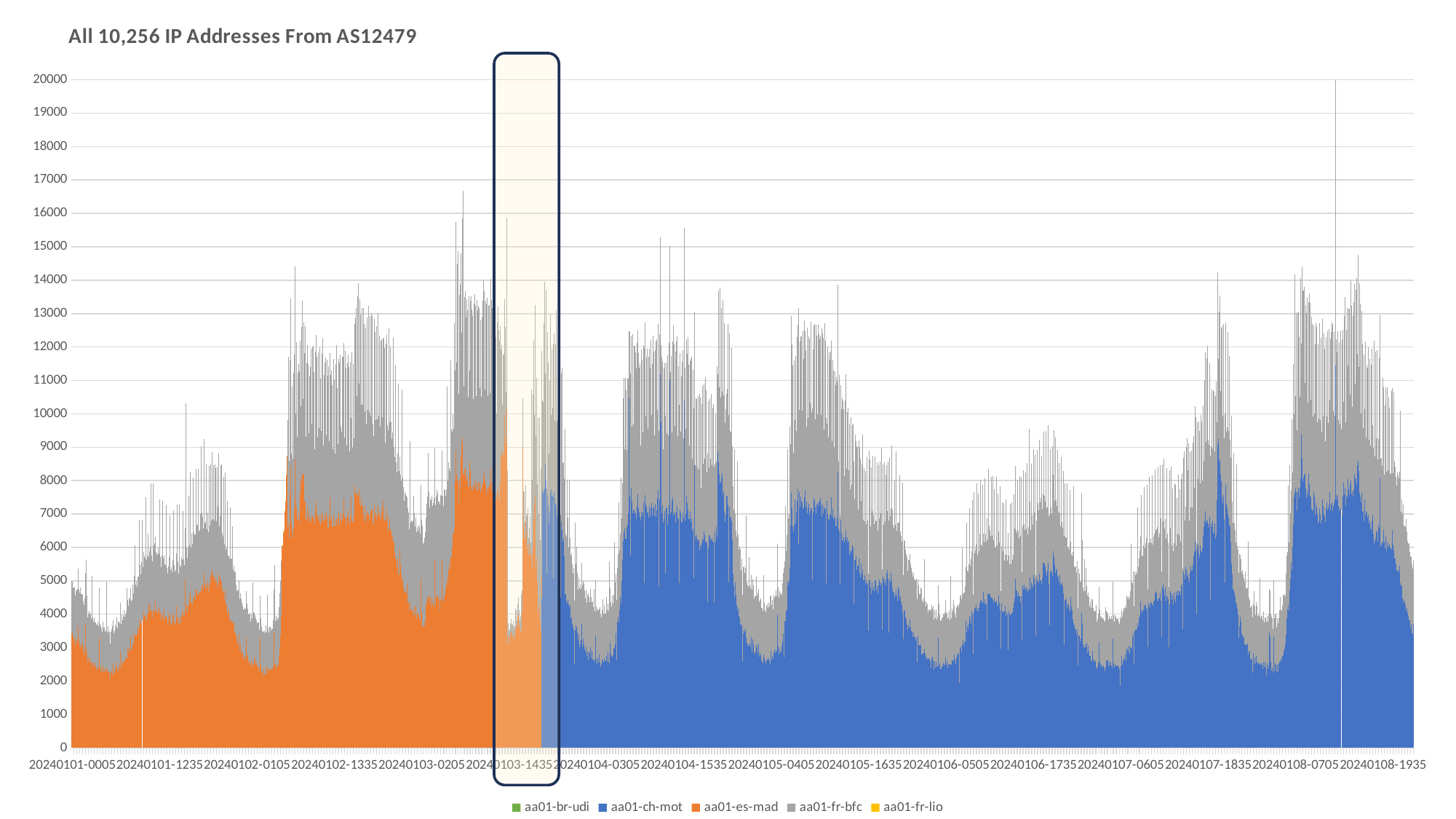
Is the total value at 20240108-0705 greater or less than 5000? greater Is the total value at 20240101-0005 greater or less than 10000? less Is the total value at 20240106-0505 greater or less than 10000? less How many date-time labels are shown along the x axis? 16 How many series does the legend list? 5 Which series occupies the bottom of the stack for the later part of the time range, aa01-ch-mot or aa01-es-mad? aa01-ch-mot What is the first x-axis label on the chart? 20240101-0005 Which series is drawn in orange? aa01-es-mad What is the title of the chart? All 10,256 IP Addresses From AS12479 Does the aa01-es-mad series appear at the beginning or the end of the time range? beginning What kind of chart is shown on the slide? Stacked area chart What is the highest value shown on the y axis? 20000